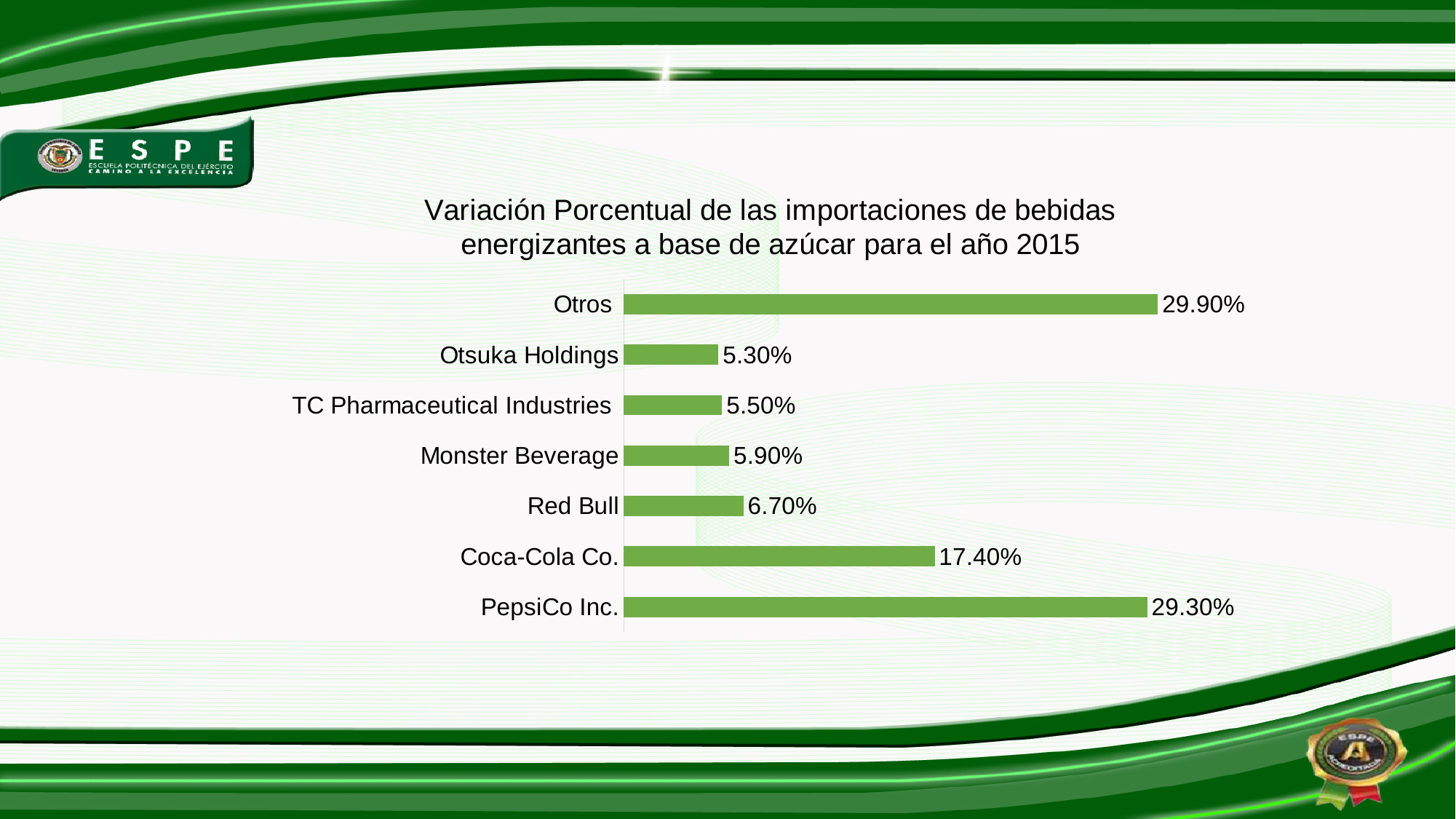
Which category has the lowest value? Otsuka Holdings How many categories are shown in the chart? 7 What is the value for Coca-Cola Co.? 17.40% What is the title of the chart? Variación Porcentual de las importaciones de bebidas energizantes a base de azúcar para el año 2015 What is the value for PepsiCo Inc.? 29.30% What is the value for Otsuka Holdings? 5.30% What is the value for Red Bull? 6.70% Which is larger, the value for Monster Beverage or the value for TC Pharmaceutical Industries? Monster Beverage Which category has the highest value? Otros What kind of chart is shown on the slide? Bar chart What is the difference between the values for Coca-Cola Co. and Red Bull? 10.70% What is the difference between the values for Otros and PepsiCo Inc.? 0.60%